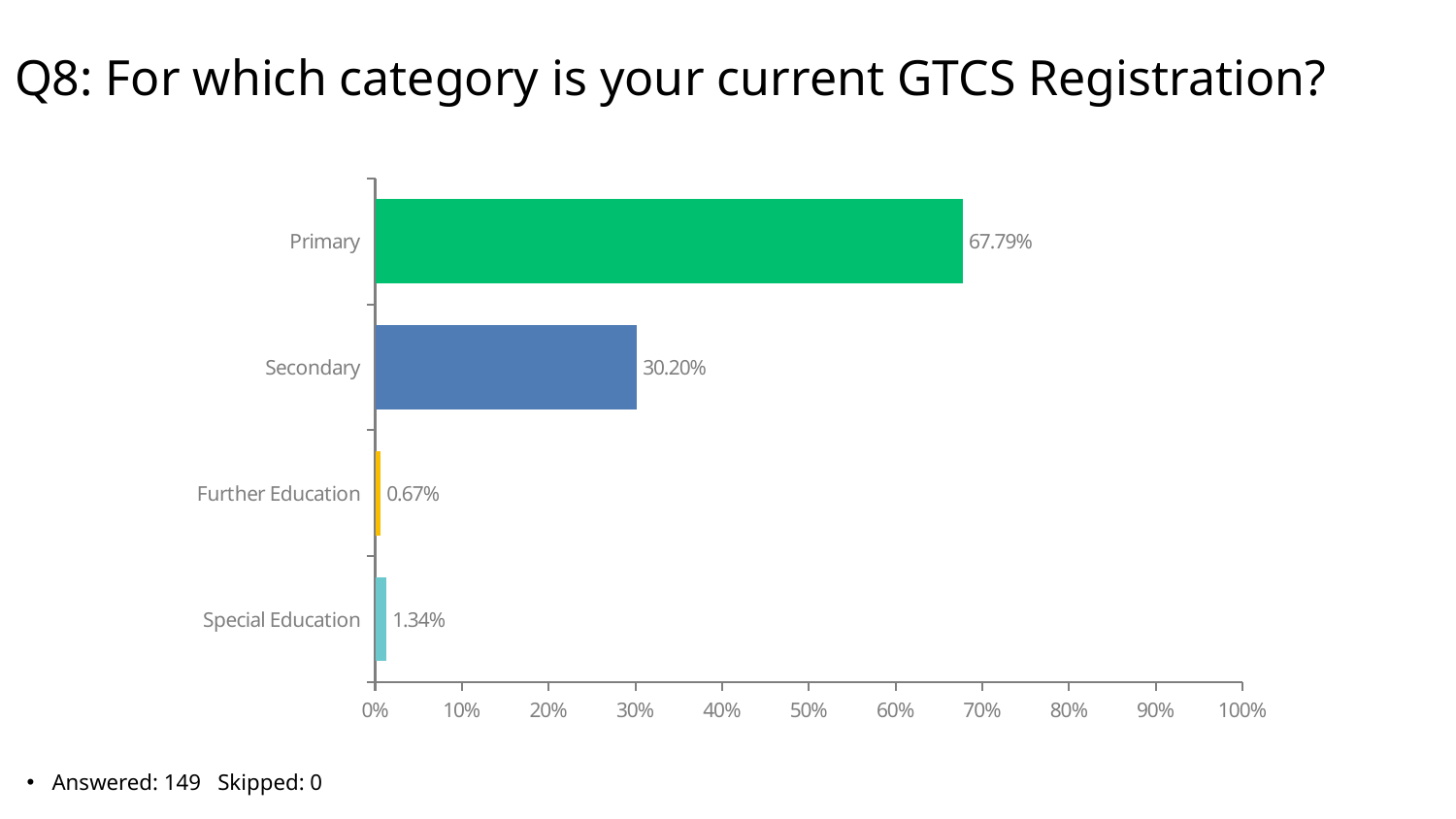
How many categories are shown in the chart? 4 What is the value shown for Special Education? 1.34% What is the value shown for Further Education? 0.67% What kind of chart is shown on the slide? Bar chart How many respondents answered this question according to the slide? 149 What percentage of respondents have their current GTCS Registration in the Primary category? 67.79% Which is larger, the value for Special Education or the value for Further Education? Special Education Which category has the highest percentage? Primary Which category has the lowest percentage? Further Education What is the value shown for Secondary? 30.20% What is the difference in percentage points between Primary and Secondary? 37.59 Is the value for Secondary greater or less than 40%? less